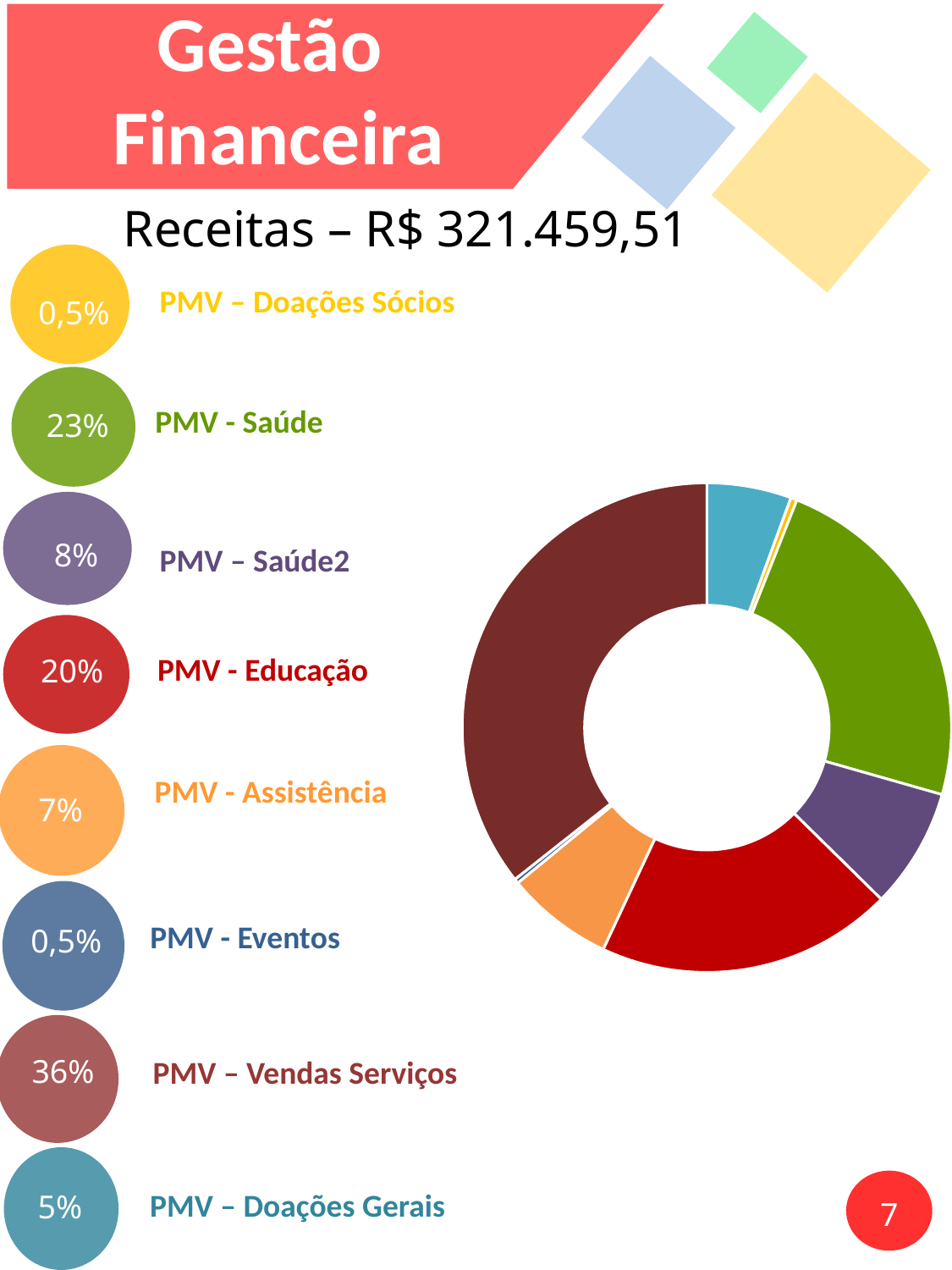
Which two categories each represent 0,5% of receipts? PMV – Doações Sócios and PMV - Eventos What share of receipts does PMV - Saúde represent? 23% What share of receipts does PMV - Educação represent? 20% What share of receipts does PMV – Saúde2 represent? 8% What kind of chart is shown on the slide? Donut (pie) chart Which category has the larger share, PMV - Saúde or PMV - Educação? PMV - Saúde How many categories are shown in the chart? 8 What share of receipts does PMV – Vendas Serviços represent? 36% What share of receipts does PMV – Doações Gerais represent? 5% What total amount of receipts (Receitas) is stated above the chart? R$ 321.459,51 Which category has the largest share of receipts? PMV – Vendas Serviços What is the difference in percentage points between PMV – Vendas Serviços and PMV - Saúde? 13 percentage points